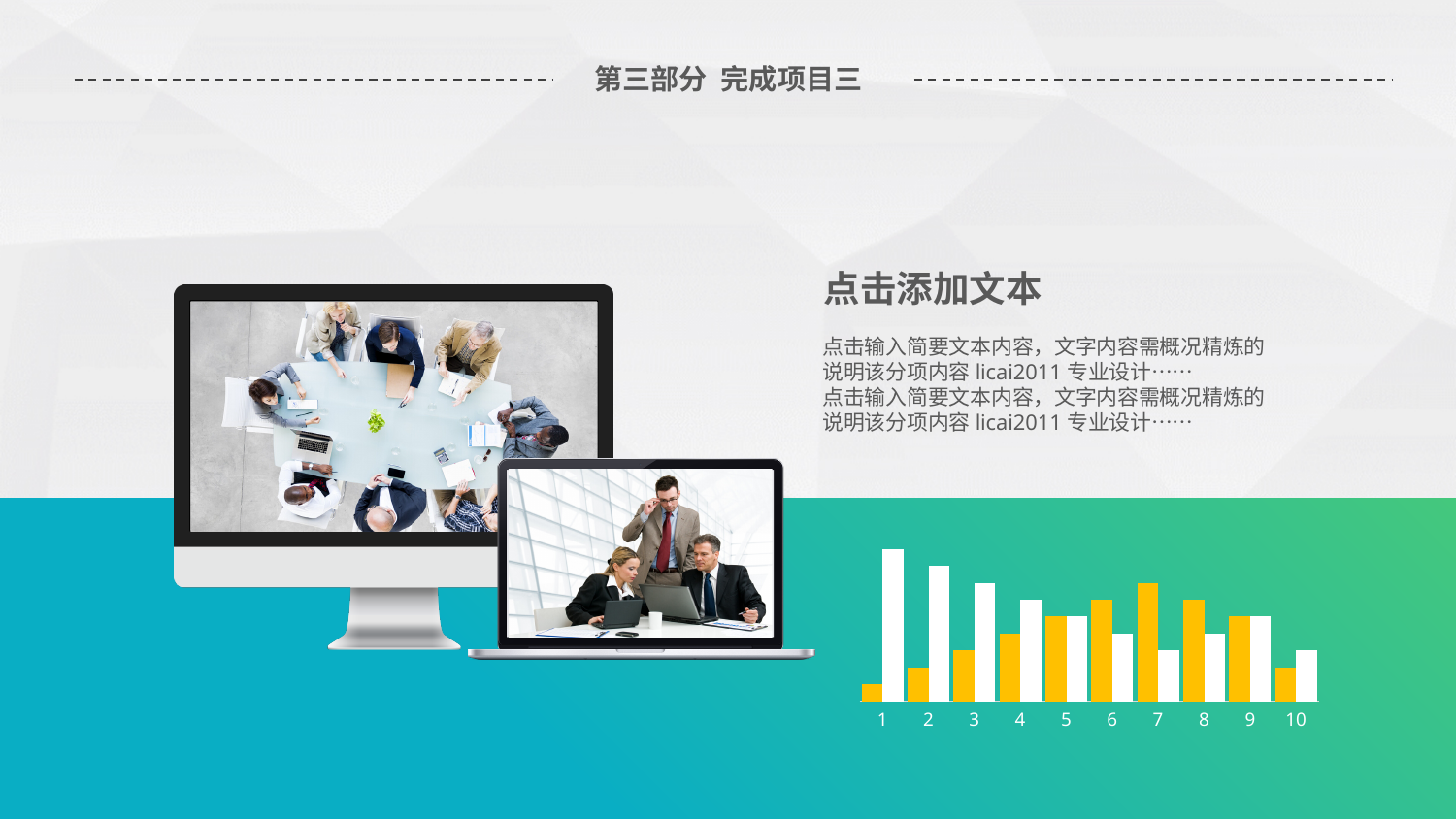
Which category has the tallest white bar? 1 Which is taller, the yellow bar for category 7 or the yellow bar for category 2? category 7 In category 1, which bar is taller, the white bar or the yellow bar? white What are the category labels on the x axis of the bar chart? 1 to 10 What two colours are the bars in the chart? yellow and white In category 7, which bar is taller, the yellow bar or the white bar? yellow Which category has the tallest yellow bar? 7 Do the yellow bars rise or fall from category 1 to category 7? rise How many categories are shown on the x axis of the bar chart? 10 Which category has the shortest yellow bar? 1 What kind of chart is shown at the bottom right of the slide? bar chart